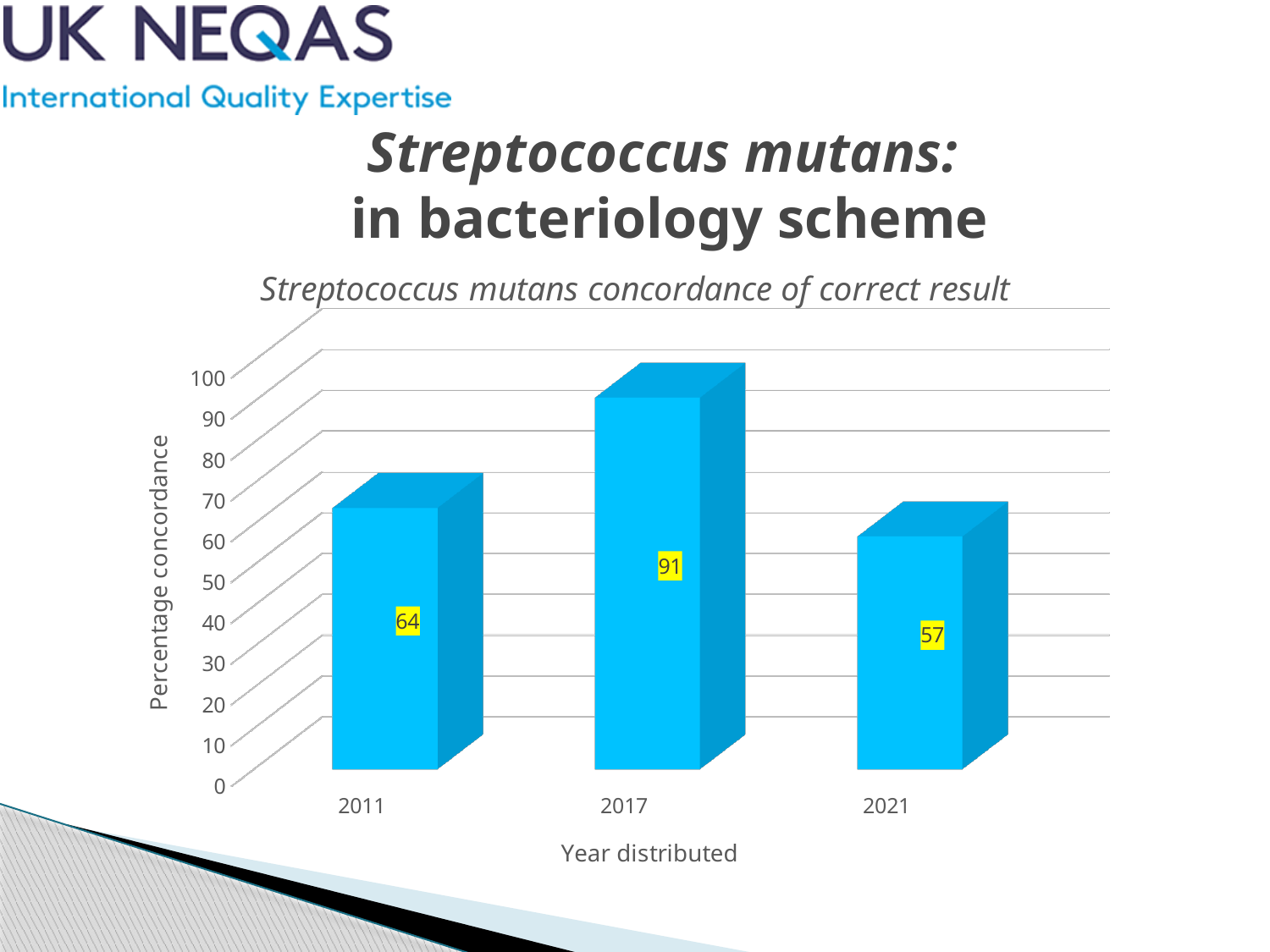
What is the difference in percentage concordance between 2011 and 2021? 7 What is the title of the chart? Streptococcus mutans concordance of correct result Which year has the lowest percentage concordance? 2021 Which year has a higher percentage concordance, 2011 or 2021? 2011 What kind of chart is shown on the slide? bar chart Which year has the highest percentage concordance? 2017 What is the percentage concordance for 2011? 64 What is the difference in percentage concordance between 2017 and 2011? 27 What is the percentage concordance for 2017? 91 Is the value for 2017 greater or less than 80? greater How many years are shown on the x axis? 3 What is the percentage concordance for 2021? 57